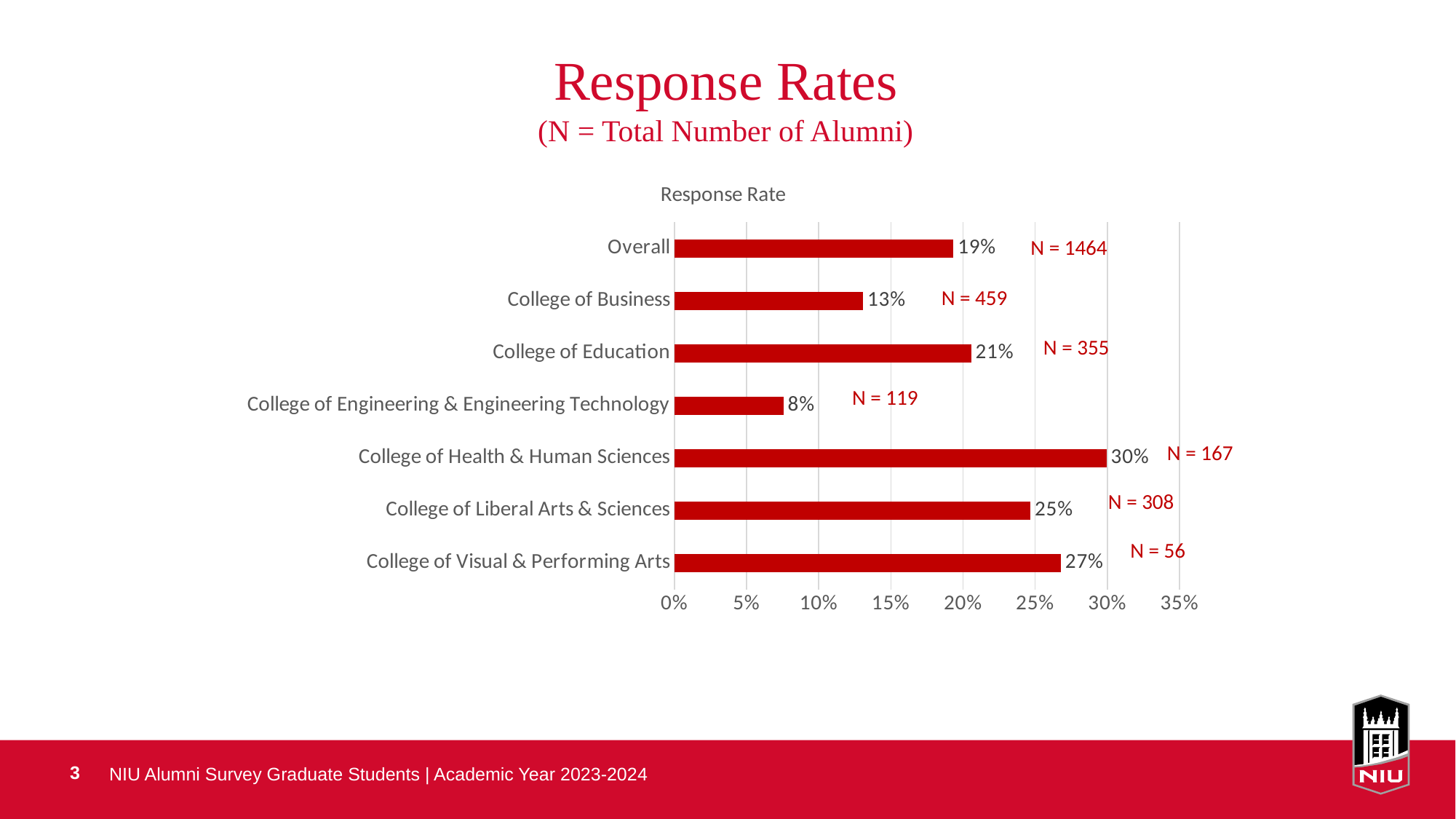
Which has a higher response rate, the College of Liberal Arts & Sciences or the College of Business? College of Liberal Arts & Sciences What is the response rate for the College of Health & Human Sciences? 30% What is the response rate for the College of Business? 13% What kind of chart is shown on the slide? Bar chart How many categories are shown on the chart? 7 What is the difference in response rate between the College of Visual & Performing Arts and the College of Education? 6% What is the total number of alumni (N) for the College of Education? 355 Which college has the highest response rate? College of Health & Human Sciences What is the title of the chart? Response Rate What is the Overall response rate? 19% What is the maximum value shown on the x axis? 35% Which college has the lowest response rate? College of Engineering & Engineering Technology